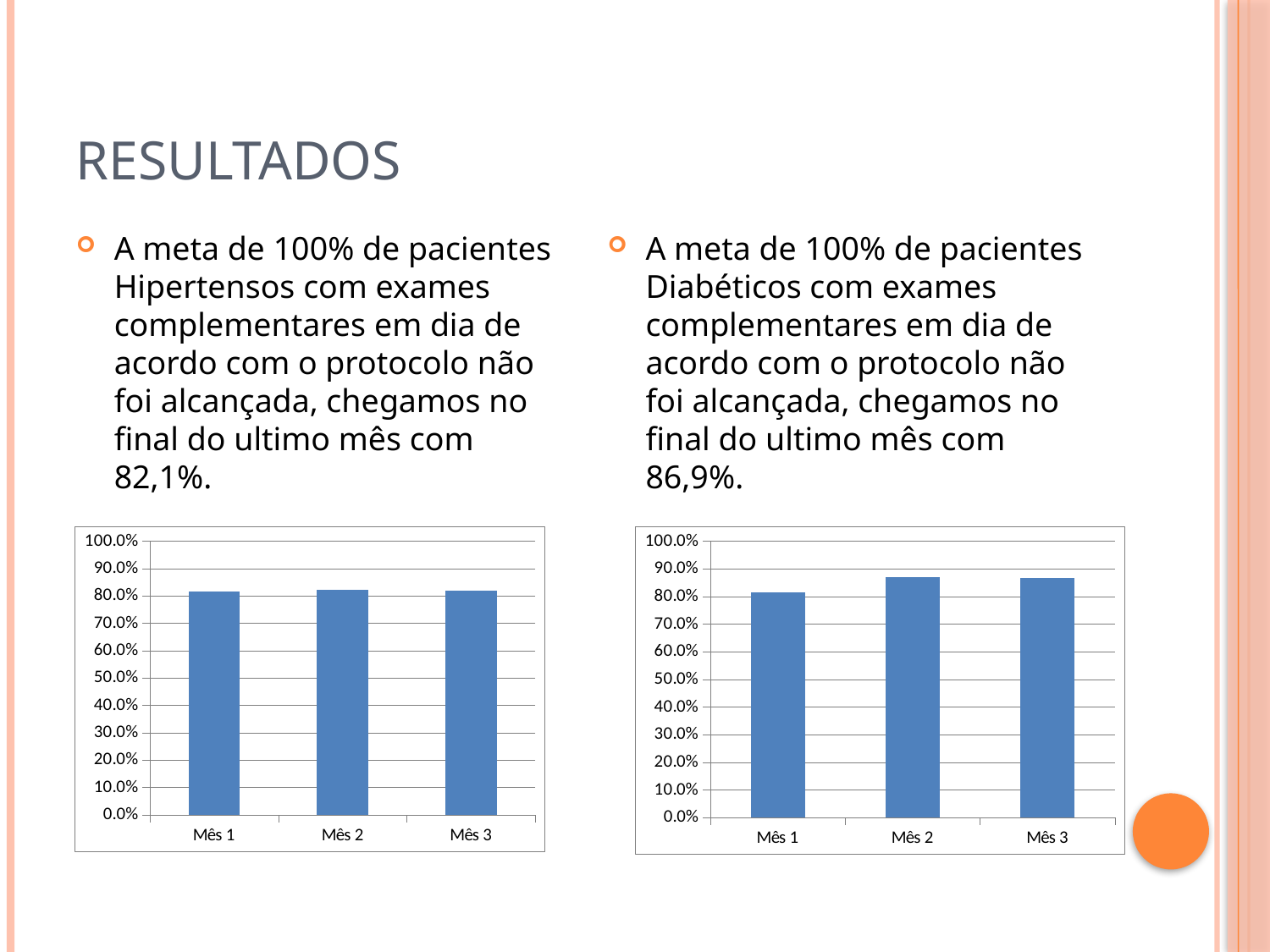
How many bars does the right chart have? 3 In the right chart, which month has the lowest value? Mês 1 In the left chart, is the value for Mês 1 greater or less than 80.0%? greater In the right chart, is the value for Mês 2 greater or less than 80.0%? greater What is the highest tick value shown on the y axis of the left chart? 100.0% How many categories are shown on the x axis of the left chart? 3 What is the label of the first category on the x axis of the right chart? Mês 1 In the left chart, is the value for Mês 3 greater or less than 90.0%? less What kind of chart is the left chart on the slide? bar chart In the right chart, which is larger, the value for Mês 1 or the value for Mês 2? Mês 2 What kind of chart is the right chart on the slide? bar chart